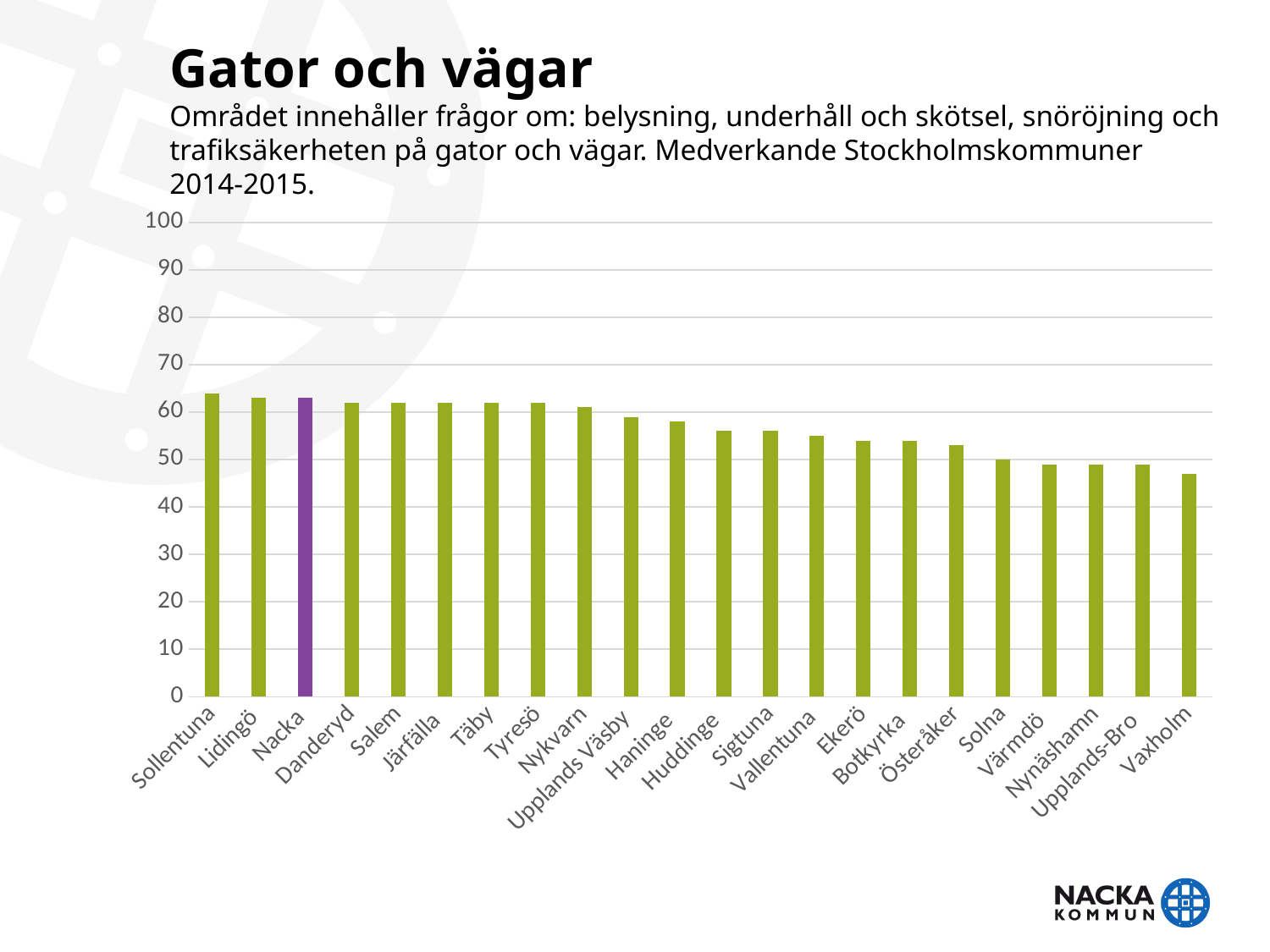
Is the value for Huddinge greater or less than 50? greater What kind of chart is shown on the slide? bar chart Which has the larger value, Sollentuna or Haninge? Sollentuna Which has the larger value, Nacka or Vaxholm? Nacka Is the value for Haninge greater or less than 60? less Do the values rise or fall from left to right along the x axis? fall Which municipality has the lowest value in the chart? Vaxholm Is the value for Nacka greater or less than 60? greater How many municipalities are shown on the x axis of the chart? 22 Which municipality's bar is highlighted in purple? Nacka